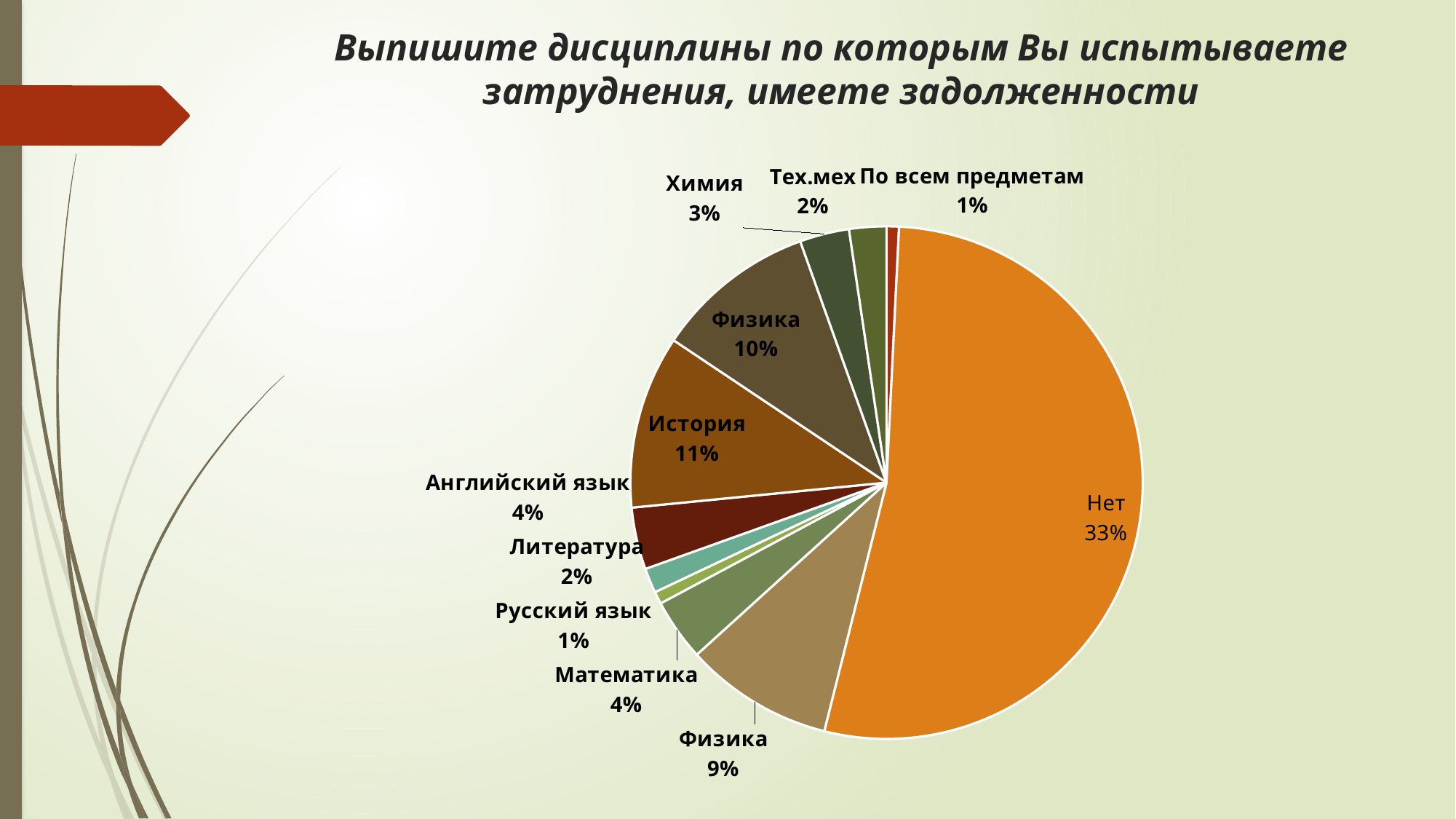
What is the value shown for По всем предметам? 1% What share of the pie does "Нет" take? 33% What kind of chart is shown on the slide? pie chart What is the value shown for История? 11% Which category has the largest share of the pie? Нет What is the value shown for Тех.мех? 2% What is the value shown for Математика? 4% What is the title of the slide? Выпишите дисциплины по которым Вы испытываете затруднения, имеете задолженности What is the difference between the values for Нет and История? 22 percentage points What is the value shown for Английский язык? 4% What is the value shown for Химия? 3% Which is larger, the value for История or the value for Химия? История